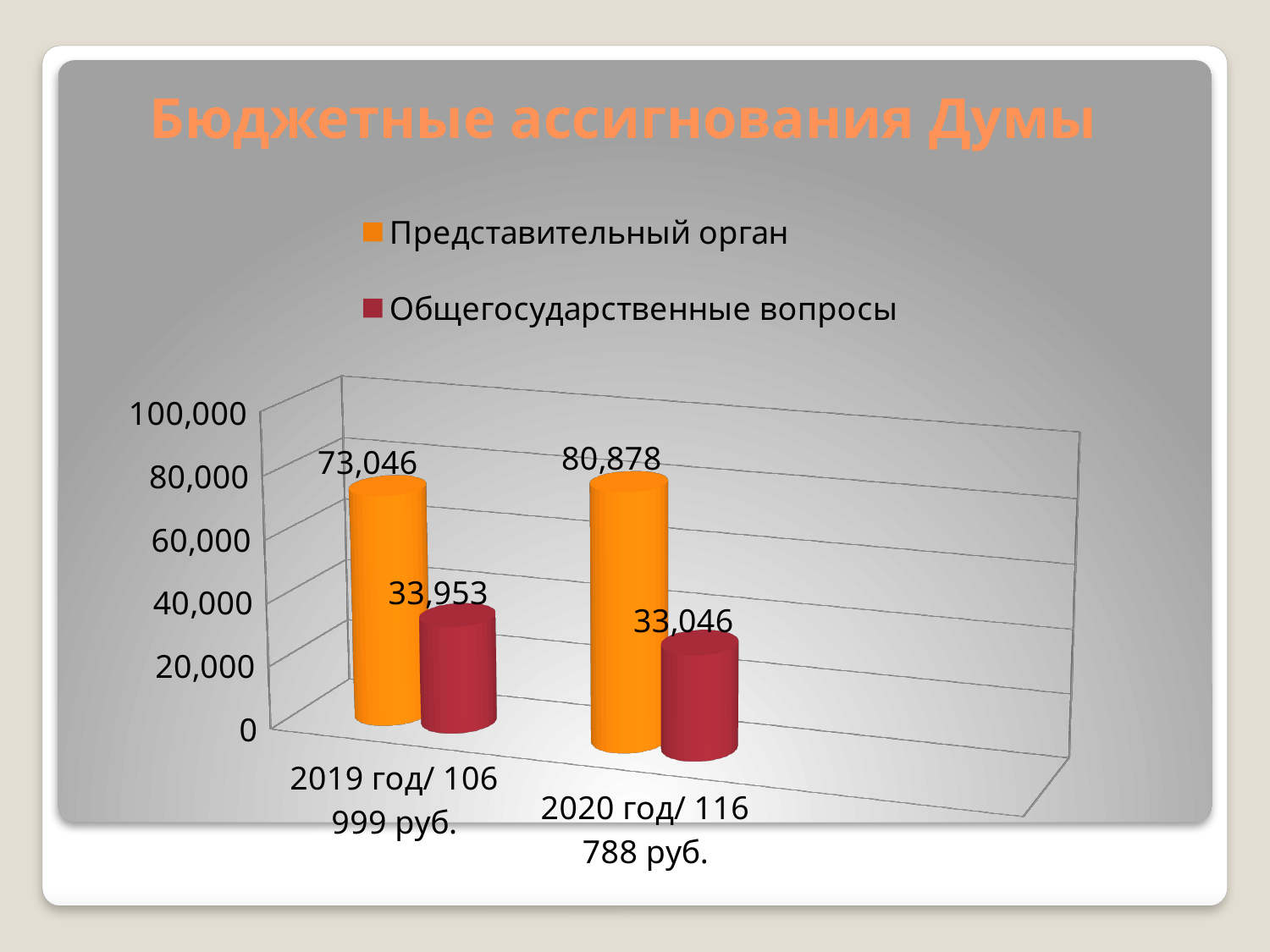
Which is larger in 2019 год/ 106 999 руб.: Представительный орган or Общегосударственные вопросы? Представительный орган What is the value for Общегосударственные вопросы in 2020 год/ 116 788 руб.? 33,046 What is the value for Представительный орган in 2020 год/ 116 788 руб.? 80,878 What is the title of the chart? Бюджетные ассигнования Думы What is the value for Представительный орган in 2019 год/ 106 999 руб.? 73,046 Which category has the highest value for Представительный орган? 2020 год/ 116 788 руб. How many categories are shown on the x axis? 2 How many series does the legend list? 2 What is the value for Общегосударственные вопросы in 2019 год/ 106 999 руб.? 33,953 Which category has the lowest value for Общегосударственные вопросы? 2020 год/ 116 788 руб. What kind of chart is shown on the slide? Bar chart What is the difference between the Представительный орган values for 2020 год/ 116 788 руб. and 2019 год/ 106 999 руб.? 7,832